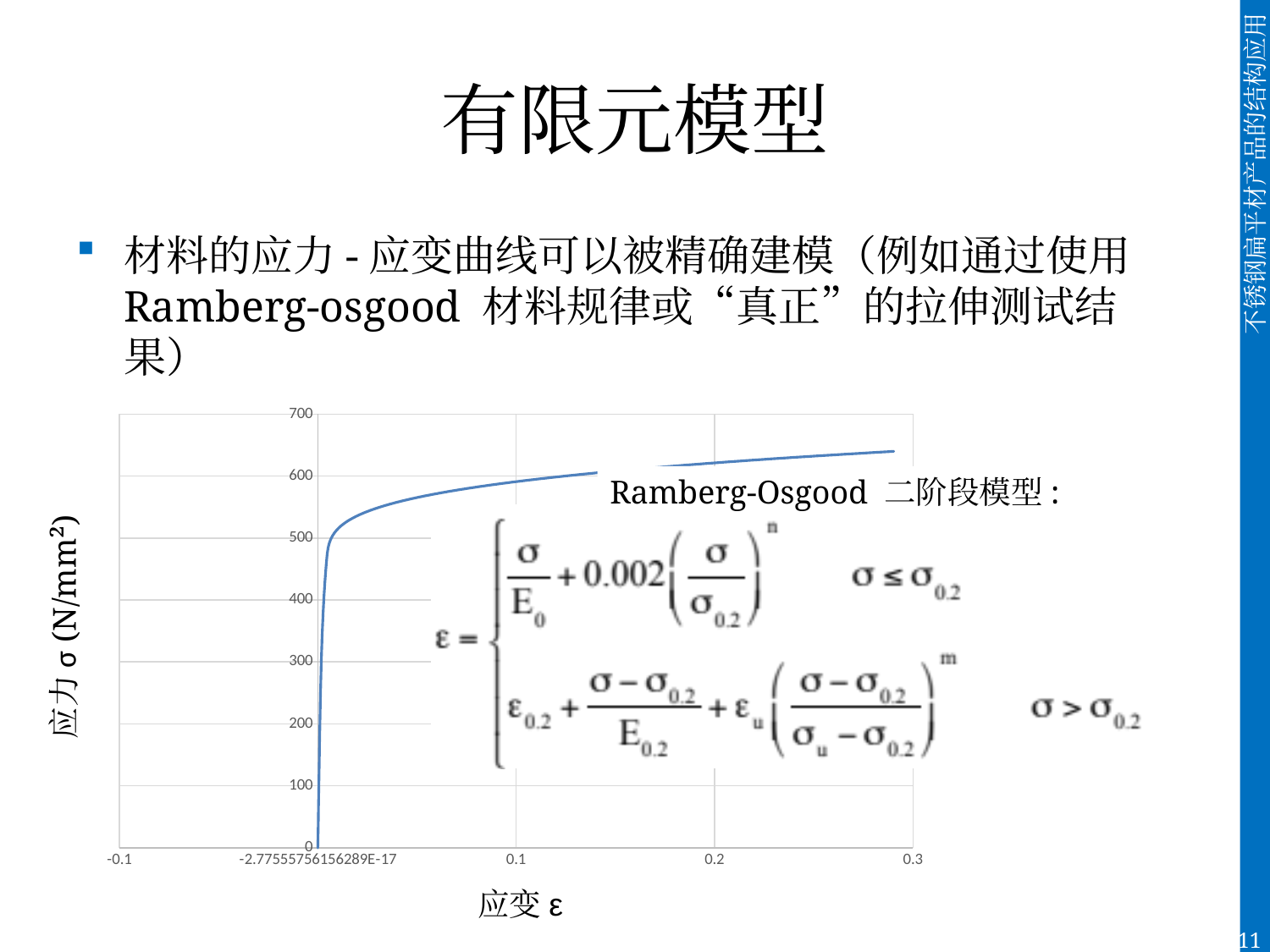
Does the stress value rise or fall as strain increases along the x axis? rise Which of the two strain values, 0.1 or 0.3, has the larger stress value on the curve? 0.3 What is the title of the horizontal axis of the chart? 应变 ε What kind of chart is shown on the slide? line chart Is the stress value at a strain of 0.3 greater or less than 600? greater Is the stress value at a strain of 0.05 greater or less than 500? greater Is the stress value at a strain of 0.1 greater or less than 500? greater What is the title of the vertical axis of the chart? 应力 σ (N/mm²)